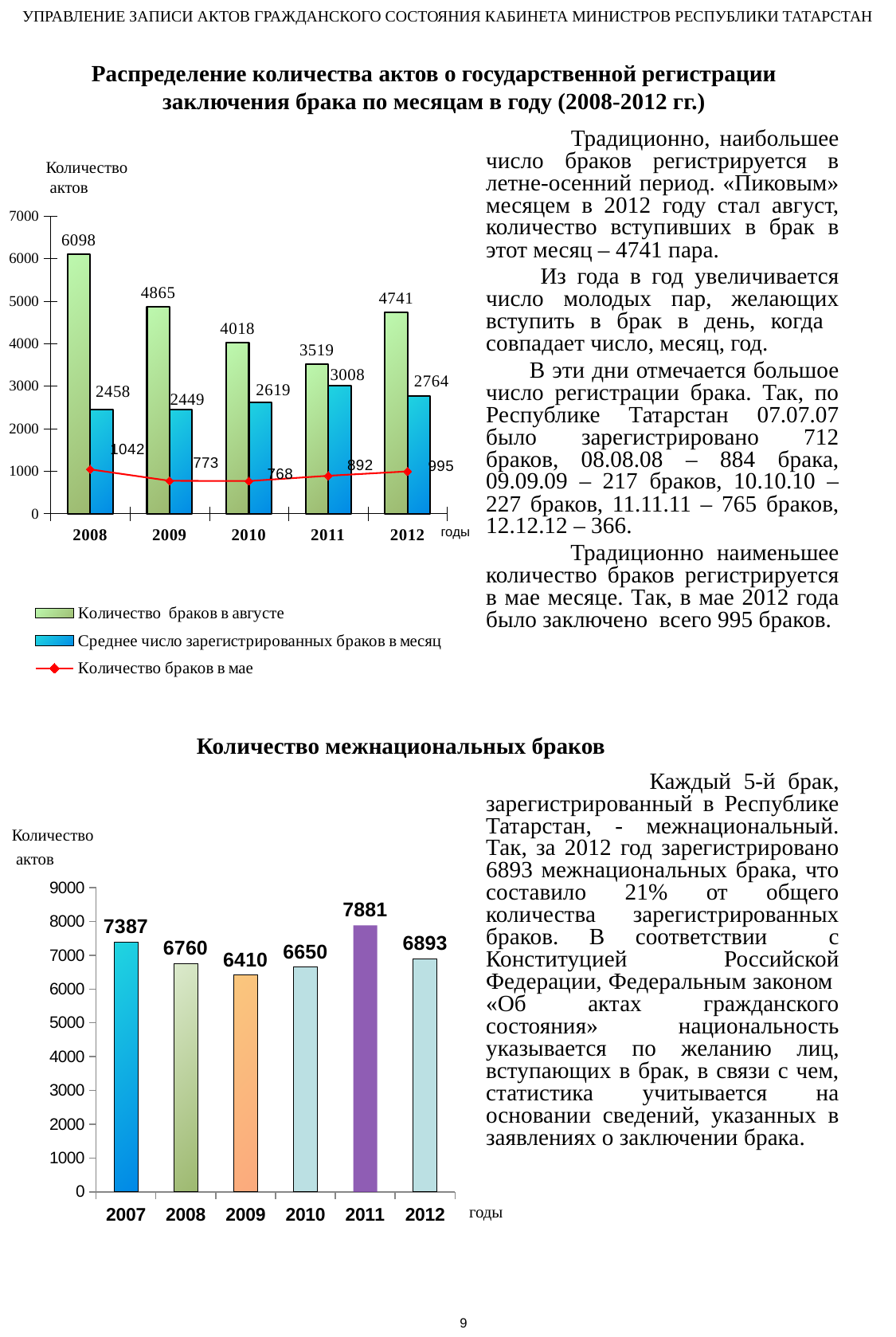
In the bottom chart (Количество межнациональных браков), which year has the highest value? 2011 In the top chart (marriage registrations by month, 2008-2012), what is the average number of registered marriages per month in 2011? 3008 In the bottom chart (Количество межнациональных браков), what is the difference between the values for 2011 and 2012? 988 In the top chart (marriage registrations by month, 2008-2012), how many series does the legend list? 3 In the top chart (marriage registrations by month, 2008-2012), which series is drawn as a red line with markers? Количество браков в мае In the bottom chart (Количество межнациональных браков), what is the value for 2009? 6410 In the top chart (marriage registrations by month, 2008-2012), what is the number of marriages in August for 2008? 6098 In the top chart (marriage registrations by month, 2008-2012), what is the difference between the August marriages and the May marriages in 2012? 3746 In the top chart (marriage registrations by month, 2008-2012), which year has the lowest number of marriages in August? 2011 In the top chart (marriage registrations by month, 2008-2012), which year has the highest number of marriages in August? 2008 In the bottom chart (Количество межнациональных браков), how many years are shown on the x axis? 6 In the top chart (marriage registrations by month, 2008-2012), what is the number of marriages in May for 2010? 768